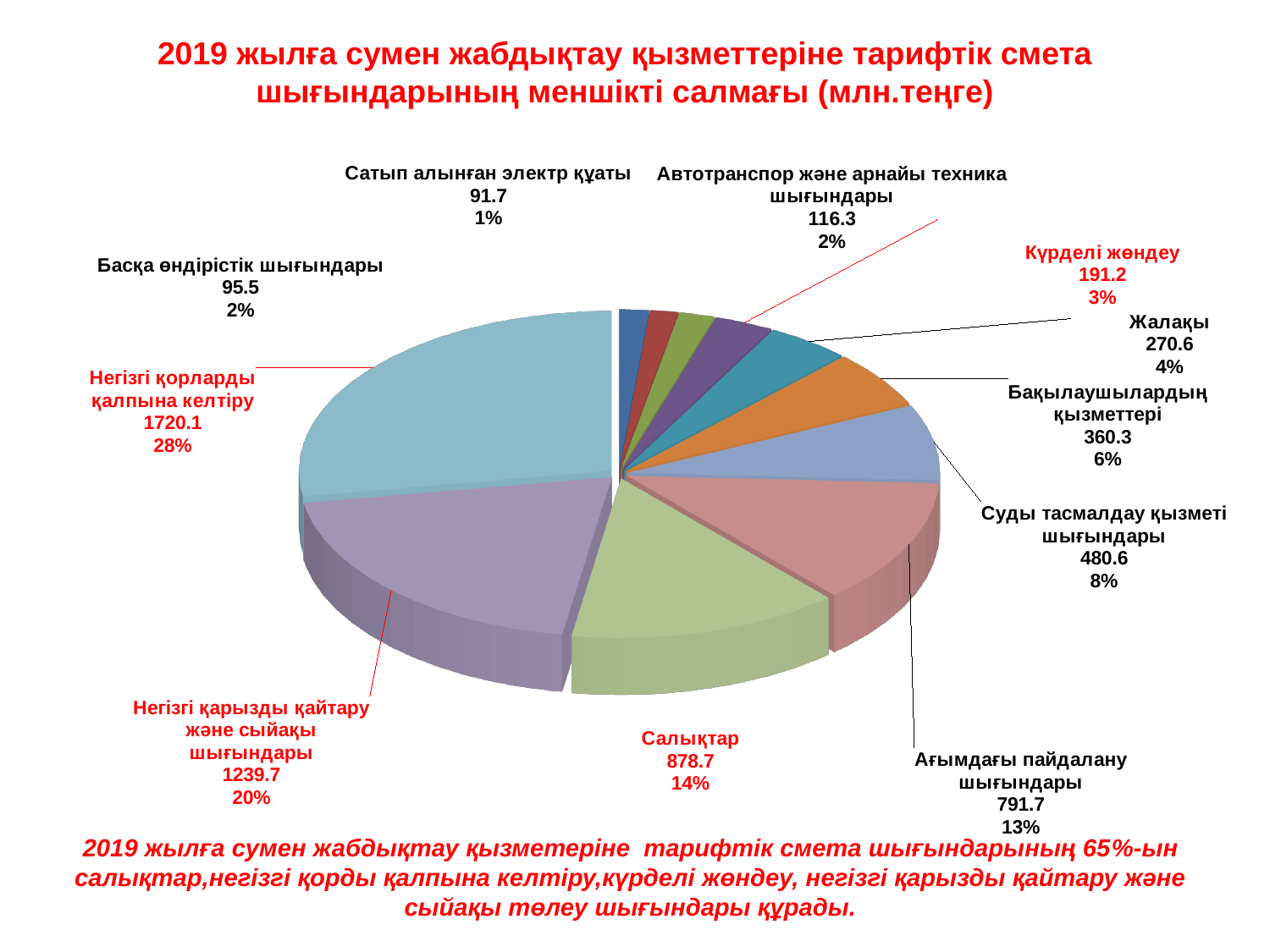
What share of the pie does Негізгі қорларды қалпына келтіру represent? 28% What unit is given in the chart title for the values? млн.теңге What share of the pie does Ағымдағы пайдалану шығындары represent? 13% What kind of chart is shown on the slide? pie chart What is the value for Салықтар? 878.7 Which category has the lowest value? Сатып алынған электр құаты What is the value for Жалақы? 270.6 How many categories (slices) does the pie chart have? 11 Which is larger, the value for Күрделі жөндеу or the value for Автотранспор және арнайы техника шығындары? Күрделі жөндеу Which category has the highest value? Негізгі қорларды қалпына келтіру What is the value for Суды тасмалдау қызметі шығындары? 480.6 What is the difference between the values for Негізгі қорларды қалпына келтіру and Негізгі қарызды қайтару және сыйақы шығындары? 480.4